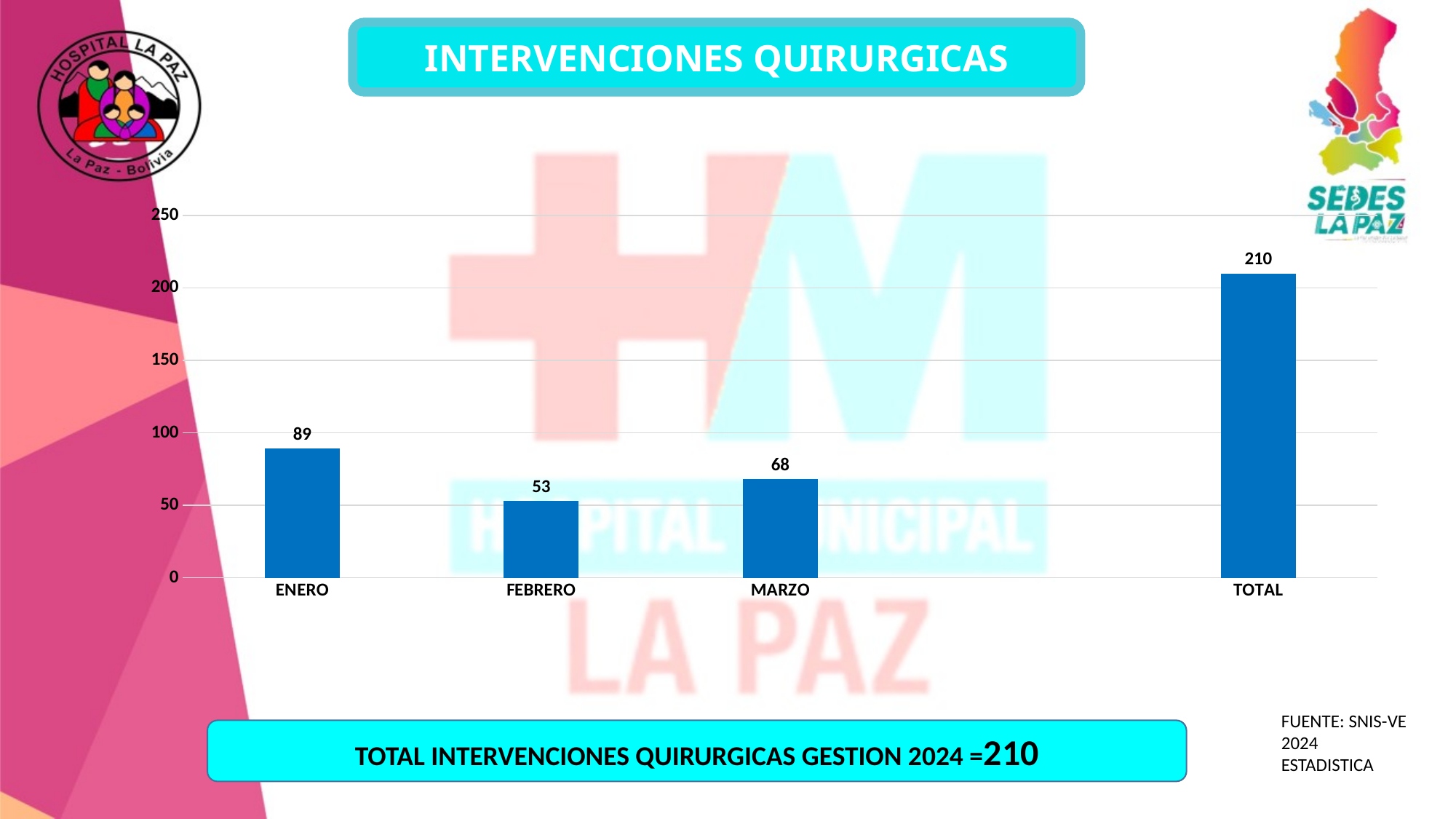
What is the value for FEBRERO? 53 What is the value for TOTAL? 210 What is the difference between the values for ENERO and FEBRERO? 36 Which month has the lowest value? FEBRERO What is the value for MARZO? 68 What is the difference between the values for MARZO and FEBRERO? 15 How many bars are shown in the chart? 4 Which month has the highest value among ENERO, FEBRERO and MARZO? ENERO Which is larger, the value for MARZO or the value for FEBRERO? MARZO What kind of chart is shown on the slide? Bar chart What is the value for ENERO? 89 What is the title of the slide's chart? INTERVENCIONES QUIRURGICAS